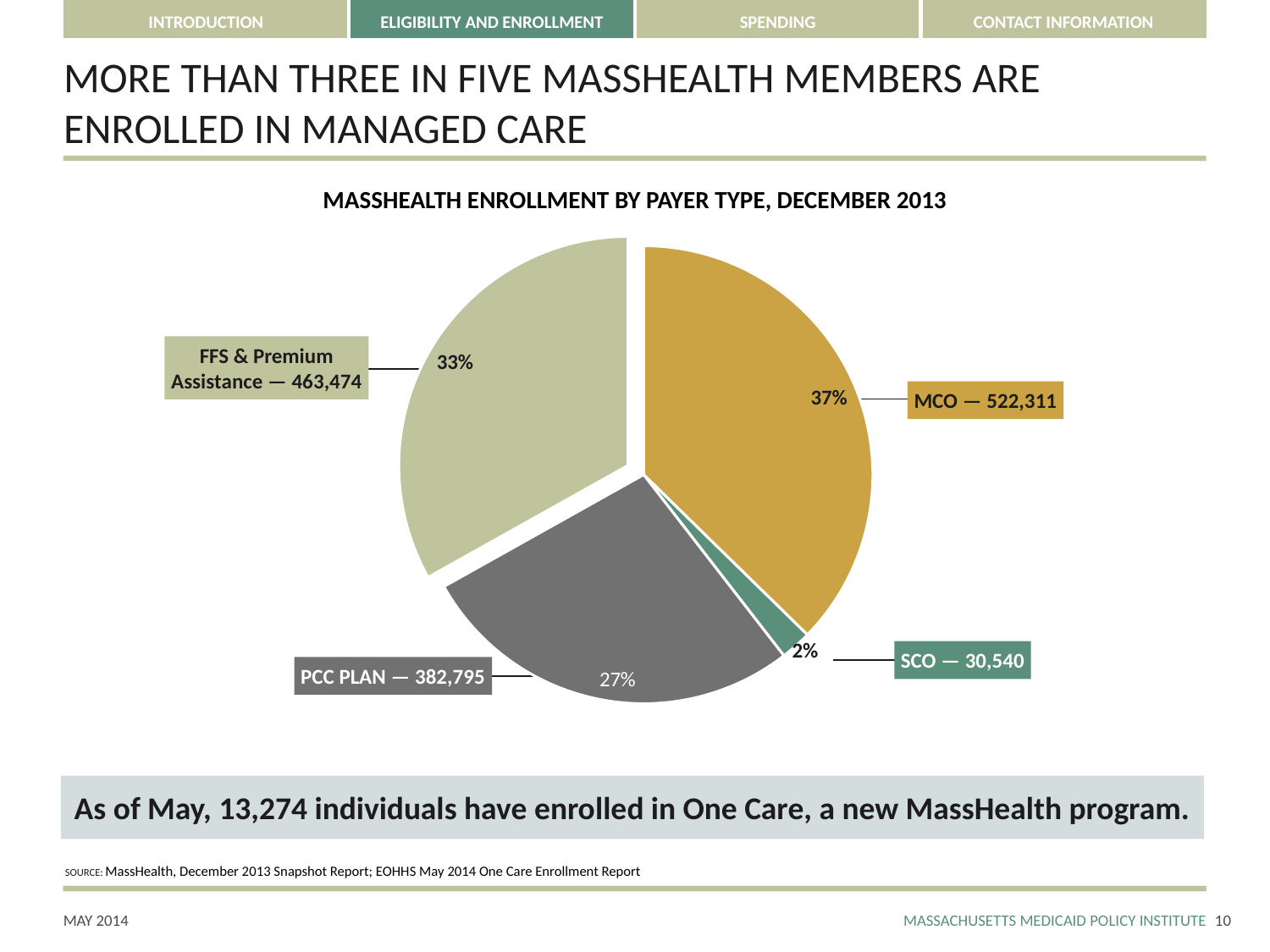
How many payer types (slices) are shown in the pie chart? 4 What percentage share of enrollment does the PCC Plan represent? 27% How many members are enrolled in the MCO payer type? 522,311 Which payer type has the smallest enrollment? SCO Which payer type has the largest enrollment? MCO What is the enrollment for the PCC Plan? 382,795 What type of chart is shown on the slide? Pie chart Which has higher enrollment, FFS & Premium Assistance or the PCC Plan? FFS & Premium Assistance What percentage share of enrollment does SCO represent? 2% What is the difference in enrollment between MCO and FFS & Premium Assistance? 58,837 What is the enrollment for FFS & Premium Assistance? 463,474 What is the title of the chart? MassHealth Enrollment by Payer Type, December 2013